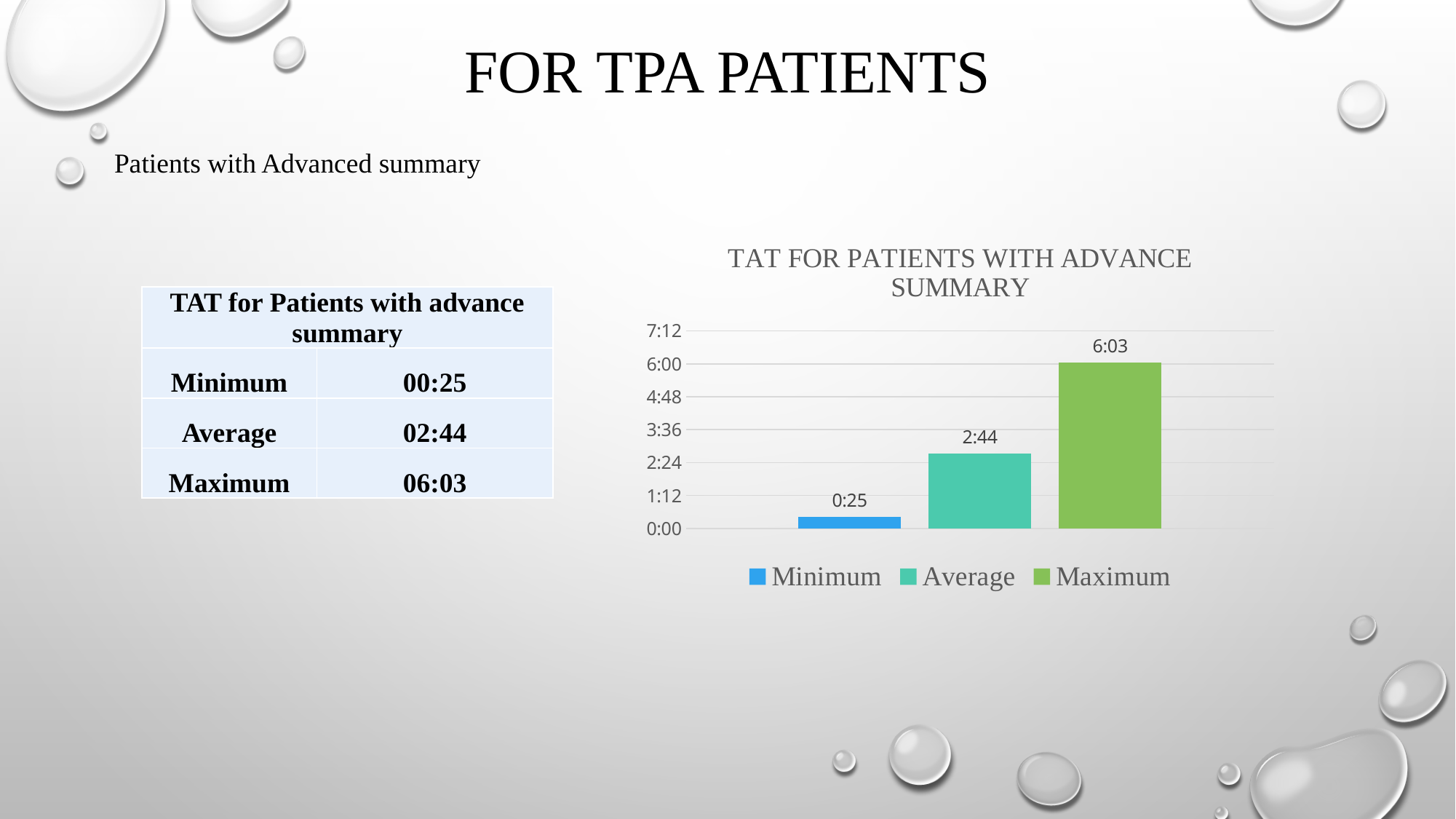
What is the value shown for Maximum in the chart? 6:03 Which series has the highest value in the chart? Maximum What is the value shown for Minimum in the chart? 0:25 Is the value for Maximum greater or less than 4:48? greater Which series has the lowest value in the chart? Minimum What kind of chart is shown on the slide? Bar chart What is the value shown for Average in the chart? 2:44 Is the value for Minimum greater or less than 1:12? less What is the title of the chart on the slide? TAT for Patients with Advance Summary How many bars are plotted in the chart? 3 Which is larger in the chart, the Average value or the Minimum value? Average How many series does the chart legend list? 3